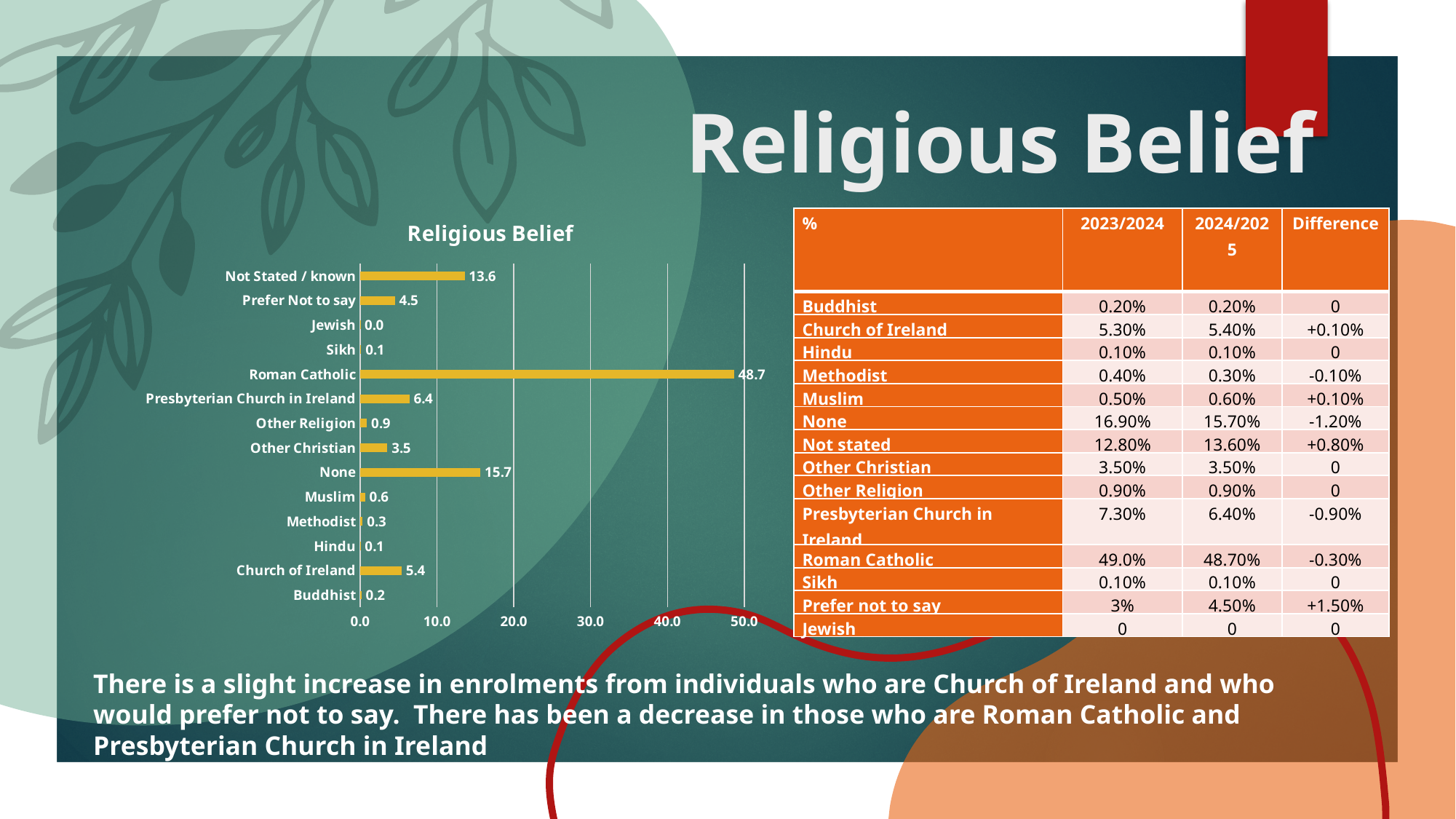
What is the value for None in the Religious Belief chart? 15.7 Which category has the lowest value in the Religious Belief chart? Jewish What is the value for Church of Ireland in the Religious Belief chart? 5.4 What is the title of the chart on the slide? Religious Belief Which is larger in the Religious Belief chart, None or Not Stated / known? None How many categories are shown in the Religious Belief chart? 14 Which category has the highest value in the Religious Belief chart? Roman Catholic Is the value for Roman Catholic in the Religious Belief chart greater or less than 40.0? greater What is the difference between the values for Roman Catholic and None in the Religious Belief chart? 33.0 What is the value for Presbyterian Church in Ireland in the Religious Belief chart? 6.4 What is the value for Roman Catholic in the Religious Belief chart? 48.7 What kind of chart is the Religious Belief chart? bar chart